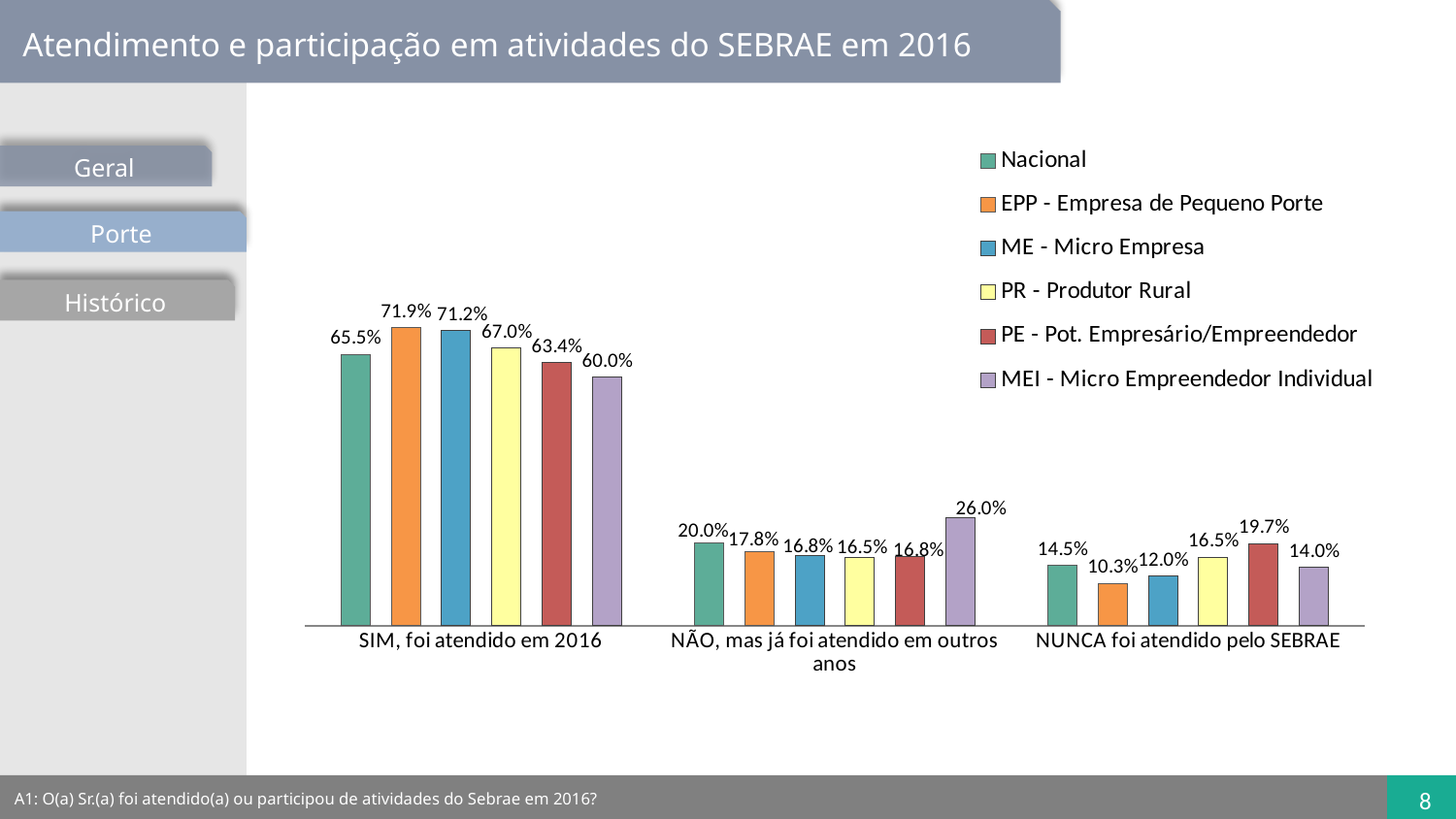
How many series does the legend list? 6 What is the value for PE - Pot. Empresário/Empreendedor in the category 'NUNCA foi atendido pelo SEBRAE'? 19.7% What kind of chart is shown on the slide? bar chart Which series has the highest value in the category 'SIM, foi atendido em 2016'? EPP - Empresa de Pequeno Porte In the category 'NUNCA foi atendido pelo SEBRAE', which is larger: the value for ME - Micro Empresa or the value for PR - Produtor Rural? PR - Produtor Rural What is the value for EPP - Empresa de Pequeno Porte in the category 'SIM, foi atendido em 2016'? 71.9% What is the difference between the Nacional value and the MEI - Micro Empreendedor Individual value in the category 'SIM, foi atendido em 2016'? 5.5% How many categories are shown on the x axis? 3 Which series has the lowest value in the category 'NUNCA foi atendido pelo SEBRAE'? EPP - Empresa de Pequeno Porte What is the Nacional value in the category 'NÃO, mas já foi atendido em outros anos'? 20.0% What is the value for MEI - Micro Empreendedor Individual in the category 'NÃO, mas já foi atendido em outros anos'? 26.0% What is the title of the slide containing the chart? Atendimento e participação em atividades do SEBRAE em 2016